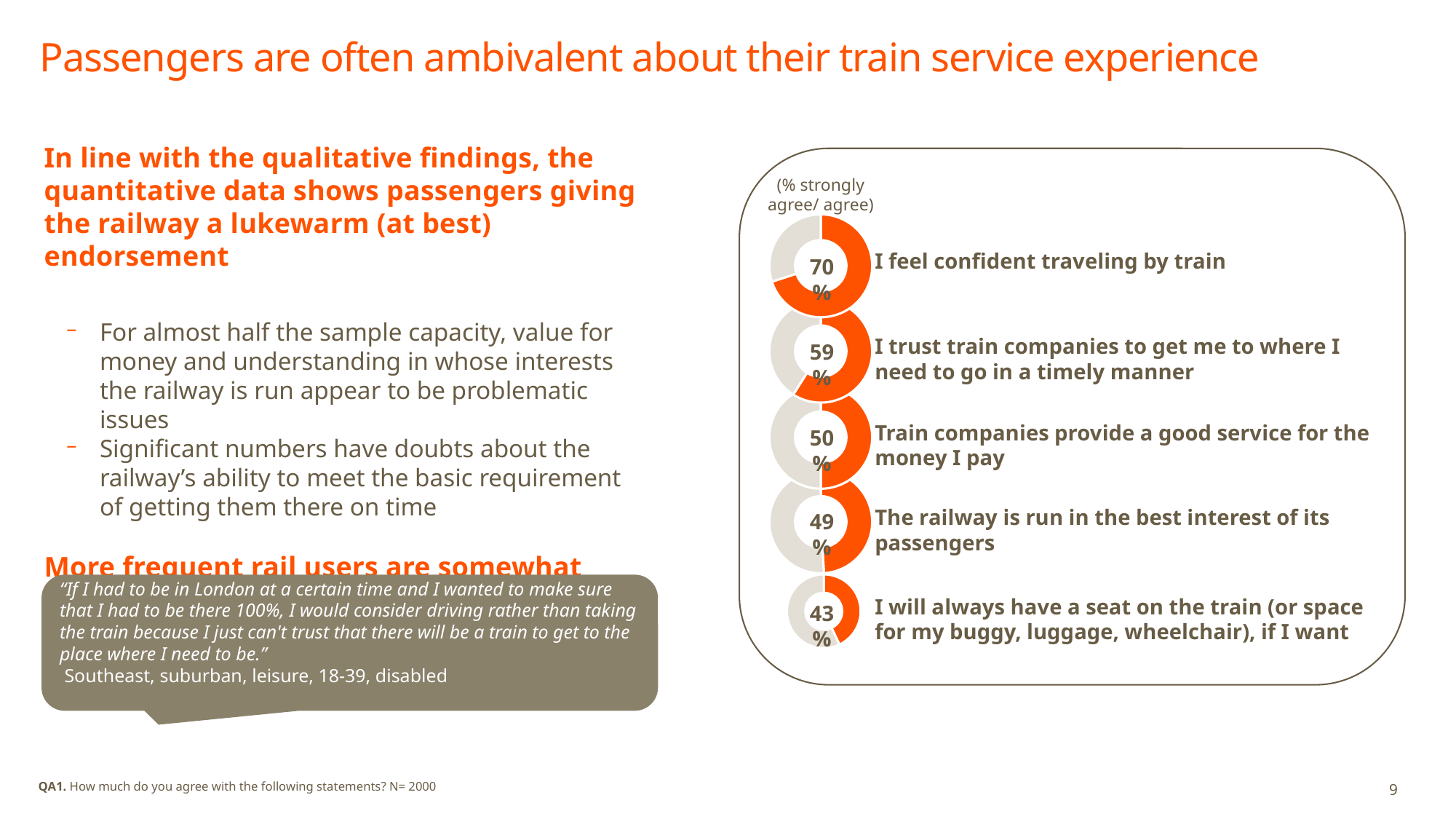
Across the five donut charts on the slide, which statement has the lowest percentage of agreement? I will always have a seat on the train (or space for my buggy, luggage, wheelchair), if I want What type of chart is used to show the agreement percentages on the slide? Donut chart Across the five donut charts on the slide, which statement has the highest percentage of agreement? I feel confident traveling by train In the donut chart for 'I trust train companies to get me to where I need to go in a timely manner', what percentage strongly agree or agree? 59% What is the difference in percentage points between the top donut chart ('I feel confident traveling by train') and the bottom donut chart ('I will always have a seat on the train')? 27 Comparing the donut charts, which is larger: the value for 'I trust train companies to get me to where I need to go in a timely manner' or the value for 'Train companies provide a good service for the money I pay'? I trust train companies to get me to where I need to go in a timely manner According to the label above the donut charts, what do the percentages represent? % strongly agree/ agree In the donut chart for 'The railway is run in the best interest of its passengers', what value is shown? 49% How many donut charts are shown on the slide? 5 In the donut chart for 'Train companies provide a good service for the money I pay', what value is shown? 50% In the donut chart for 'I feel confident traveling by train', what percentage strongly agree or agree? 70% In the bottom donut chart, for 'I will always have a seat on the train (or space for my buggy, luggage, wheelchair), if I want', what percentage is shown? 43%